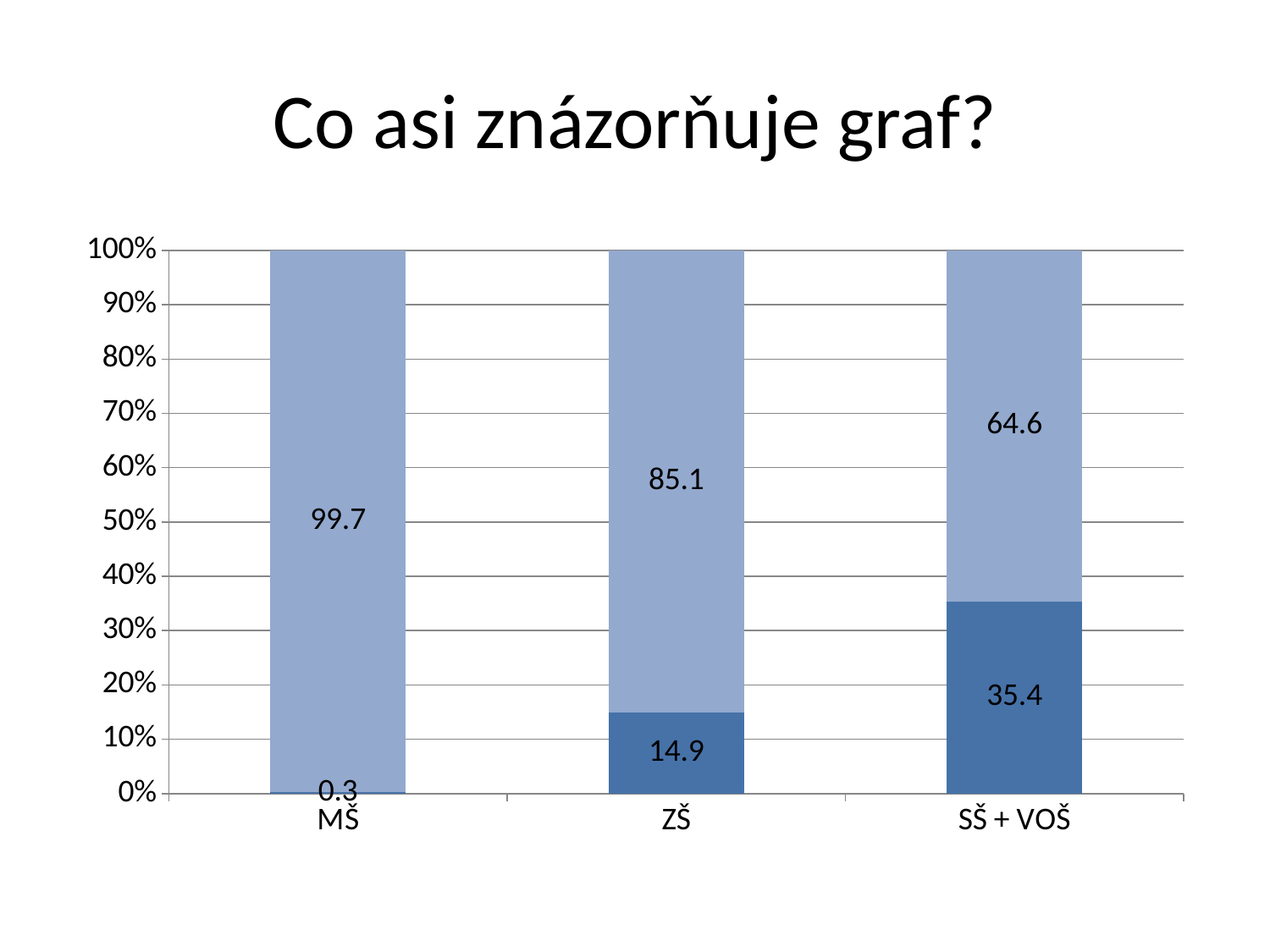
How many categories are shown on the x axis of the chart? 3 What is the value of the lighter (upper) segment for MŠ? 99.7 Which has a larger darker (lower) segment value, ZŠ or SŠ + VOŠ? SŠ + VOŠ What is the value of the darker (lower) segment for SŠ + VOŠ? 35.4 What is the value of the darker (lower) segment for ZŠ? 14.9 What kind of chart is shown on the slide? Stacked bar chart Does the darker (lower) segment rise or fall from MŠ to SŠ + VOŠ along the x axis? Rises What is the value of the lighter (upper) segment for SŠ + VOŠ? 64.6 What is the difference between the lighter and darker segment values for ZŠ? 70.2 Which category has the smallest darker (lower) segment? MŠ What is the title of the slide? Co asi znázorňuje graf? Which category has the largest darker (lower) segment? SŠ + VOŠ